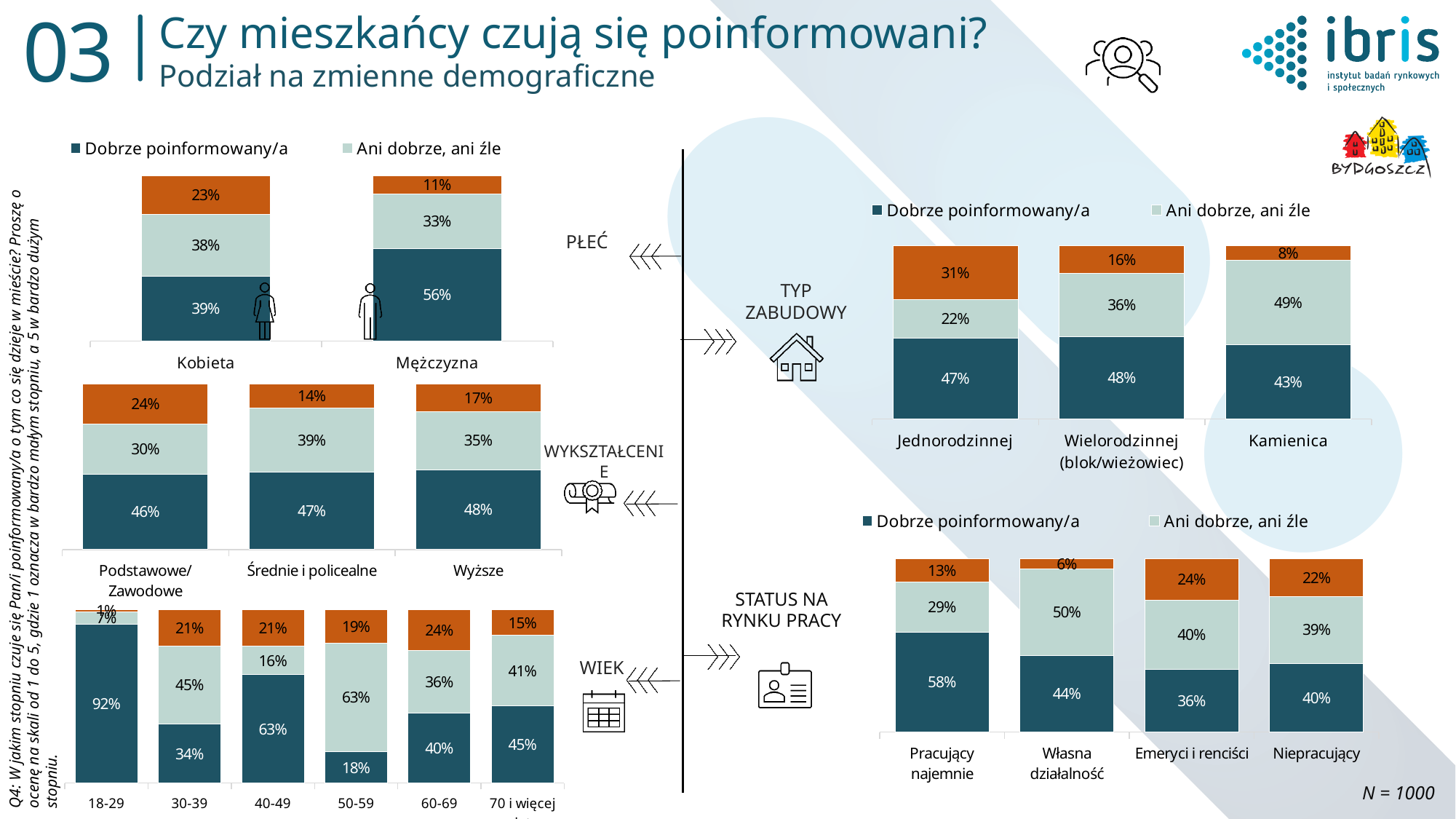
In the STATUS NA RYNKU PRACY chart, what is the 'Dobrze poinformowany/a' value for Pracujący najemnie? 58% In the STATUS NA RYNKU PRACY chart, what is the difference between the 'Ani dobrze, ani źle' values for Własna działalność and Pracujący najemnie? 21% What type of chart is the TYP ZABUDOWY chart? Stacked bar chart In the PŁEĆ chart, what is the difference between the 'Dobrze poinformowany/a' values for Mężczyzna and Kobieta? 17% In the PŁEĆ chart, what is the 'Dobrze poinformowany/a' value for Mężczyzna? 56% In the WYKSZTAŁCENIE chart, what is the 'Ani dobrze, ani źle' value for Średnie i policealne? 39% In the WIEK chart, how many age categories are shown? 6 In the WYKSZTAŁCENIE chart, which category has the highest 'Dobrze poinformowany/a' value? Wyższe In the TYP ZABUDOWY chart, which is larger: the 'Dobrze poinformowany/a' value for Jednorodzinnej or for Kamienica? Jednorodzinnej In the WIEK chart, which age group has the lowest 'Dobrze poinformowany/a' value? 50-59 In the TYP ZABUDOWY chart, what is the 'Ani dobrze, ani źle' value for Kamienica? 49% In the WIEK chart, what is the 'Dobrze poinformowany/a' value for 18-29? 92%